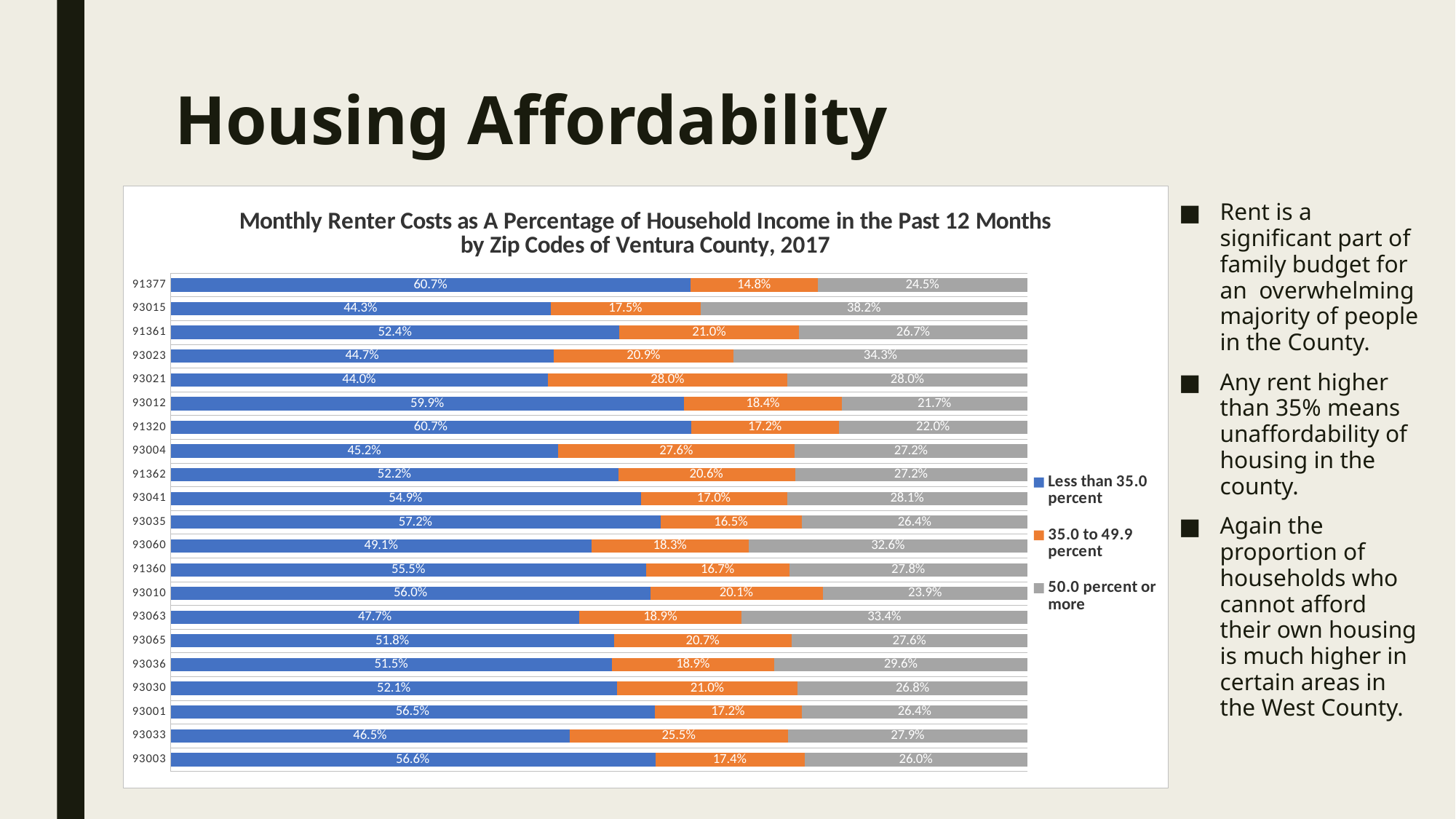
Which zip code has the lowest value for the 'Less than 35.0 percent' series? 93021 What is the title of the chart? Monthly Renter Costs as A Percentage of Household Income in the Past 12 Months by Zip Codes of Ventura County, 2017 How many zip codes are plotted on the chart? 21 Which zip code has the highest value for the '50.0 percent or more' series? 93015 What is the difference between the '50.0 percent or more' values for zip codes 93015 and 93012? 16.5 percentage points How many series does the legend list? 3 What type of chart is shown on the slide? Stacked bar chart What is the value of the '35.0 to 49.9 percent' series for zip code 93033? 25.5% What is the value of the '50.0 percent or more' series for zip code 93063? 33.4% What is the value of the 'Less than 35.0 percent' series for zip code 93015? 44.3% Which has a larger '35.0 to 49.9 percent' value: zip code 93004 or zip code 93041? 93004 Which zip code has the highest value for the '35.0 to 49.9 percent' series? 93021